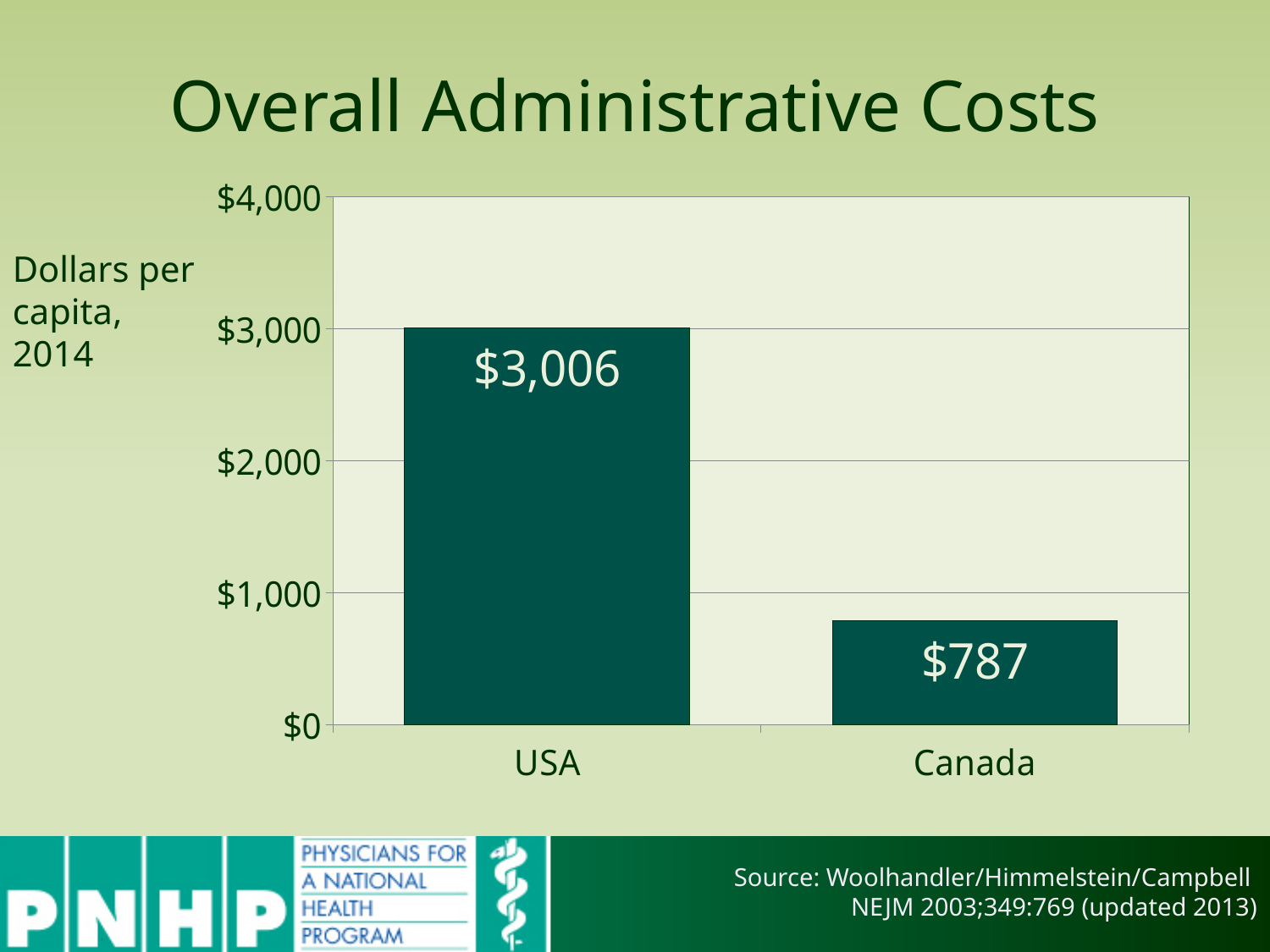
Which category has the highest value? USA What is the value for Canada? $787 How many categories are shown on the chart? 2 Is the value for USA greater or less than $3,000? greater What kind of chart is shown on the slide? bar chart What is the title of the chart? Overall Administrative Costs What unit does the y-axis label describe? Dollars per capita, 2014 What is the difference between the values for USA and Canada? $2,219 Is the value for Canada greater or less than $1,000? less What is the value for USA? $3,006 Which category has the lowest value? Canada Which is larger, the value for USA or the value for Canada? USA